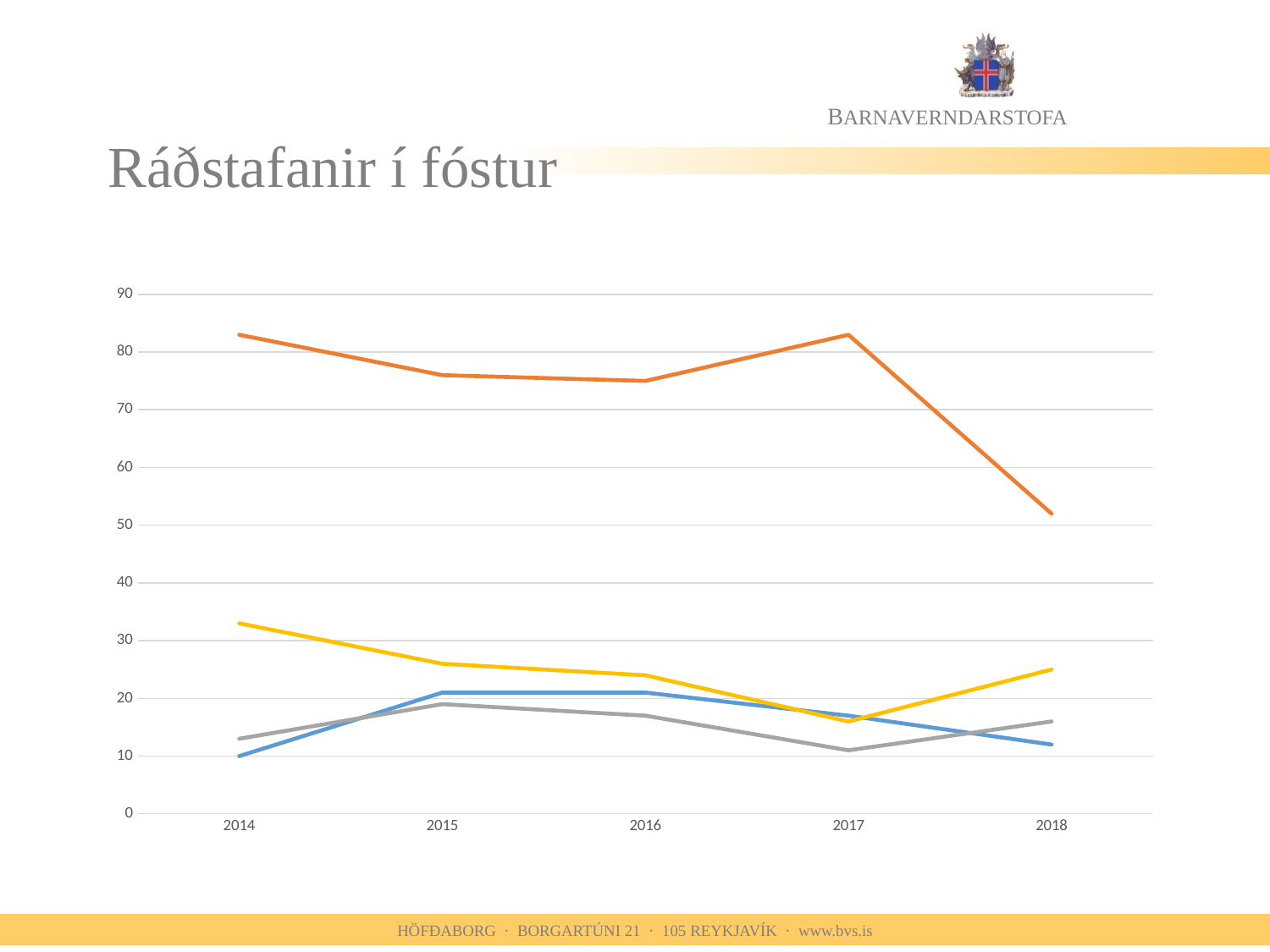
Is the value of the orange line in 2018 greater or less than 60? less What kind of chart is shown on the slide? line chart Is the value of the orange line in 2014 greater or less than 80? greater In which year is the yellow line at its highest value? 2014 Is the value of the yellow line in 2014 greater or less than 30? greater Does the orange line rise or fall between 2017 and 2018? fall How many years are shown along the x axis of the chart? 5 In which year is the orange line at its lowest value? 2018 What is the title of the slide containing the chart? Ráðstafanir í fóstur How many lines are plotted on the chart? 4